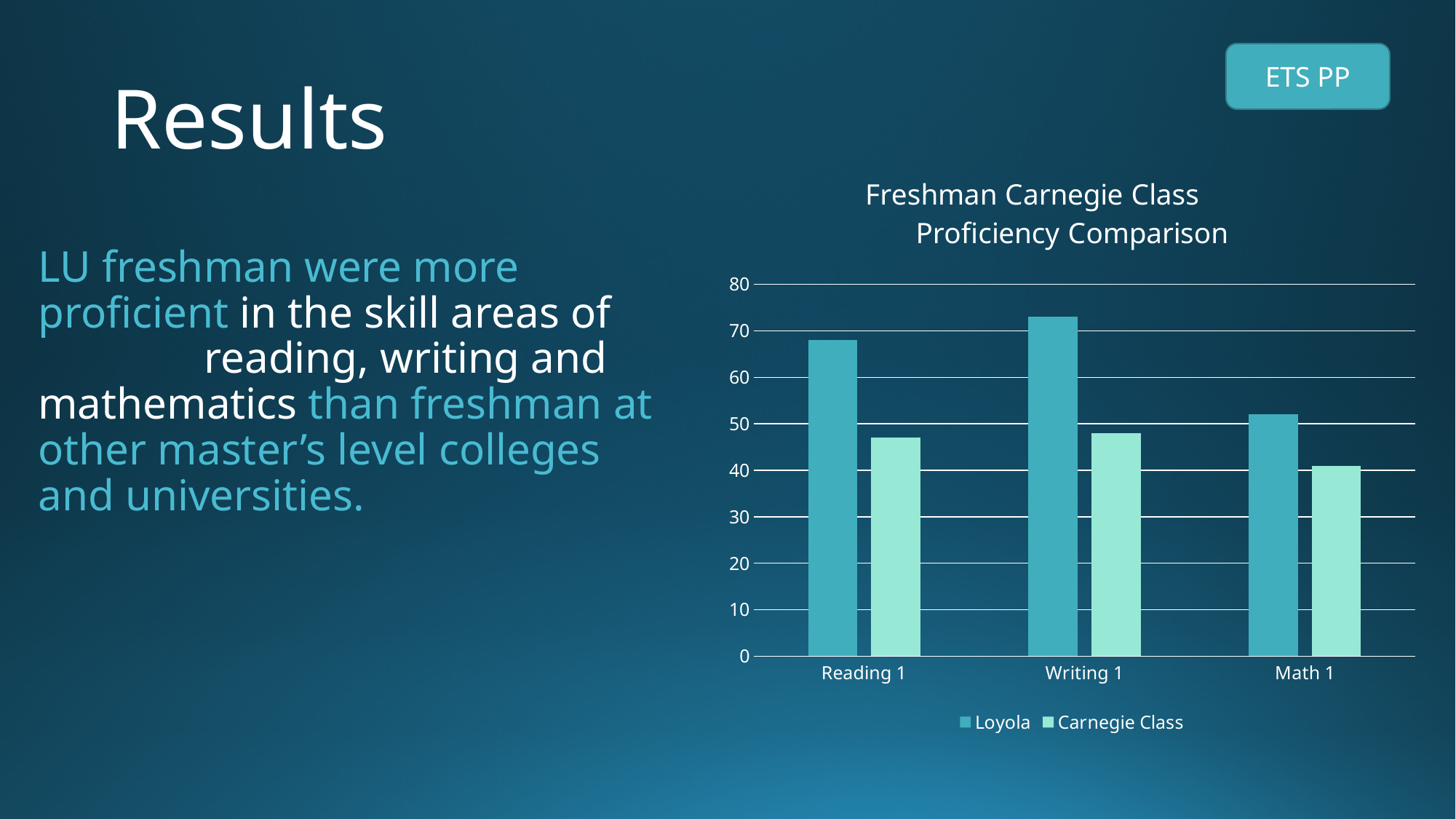
What is the title of the chart? Freshman Carnegie Class Proficiency Comparison Is the Loyola value for Writing 1 greater or less than 70? greater Is the Loyola value for Reading 1 greater or less than 60? greater How many series does the chart's legend list? 2 What kind of chart is shown on the slide? bar chart How many categories are shown on the x axis of the chart? 3 In which category is the Loyola value highest? Writing 1 In which category is the Carnegie Class value lowest? Math 1 For Reading 1, which series has the larger value, Loyola or Carnegie Class? Loyola In which category is the Loyola value lowest? Math 1 What are the two series named in the chart's legend? Loyola and Carnegie Class Is the Carnegie Class value for Math 1 greater or less than 50? less